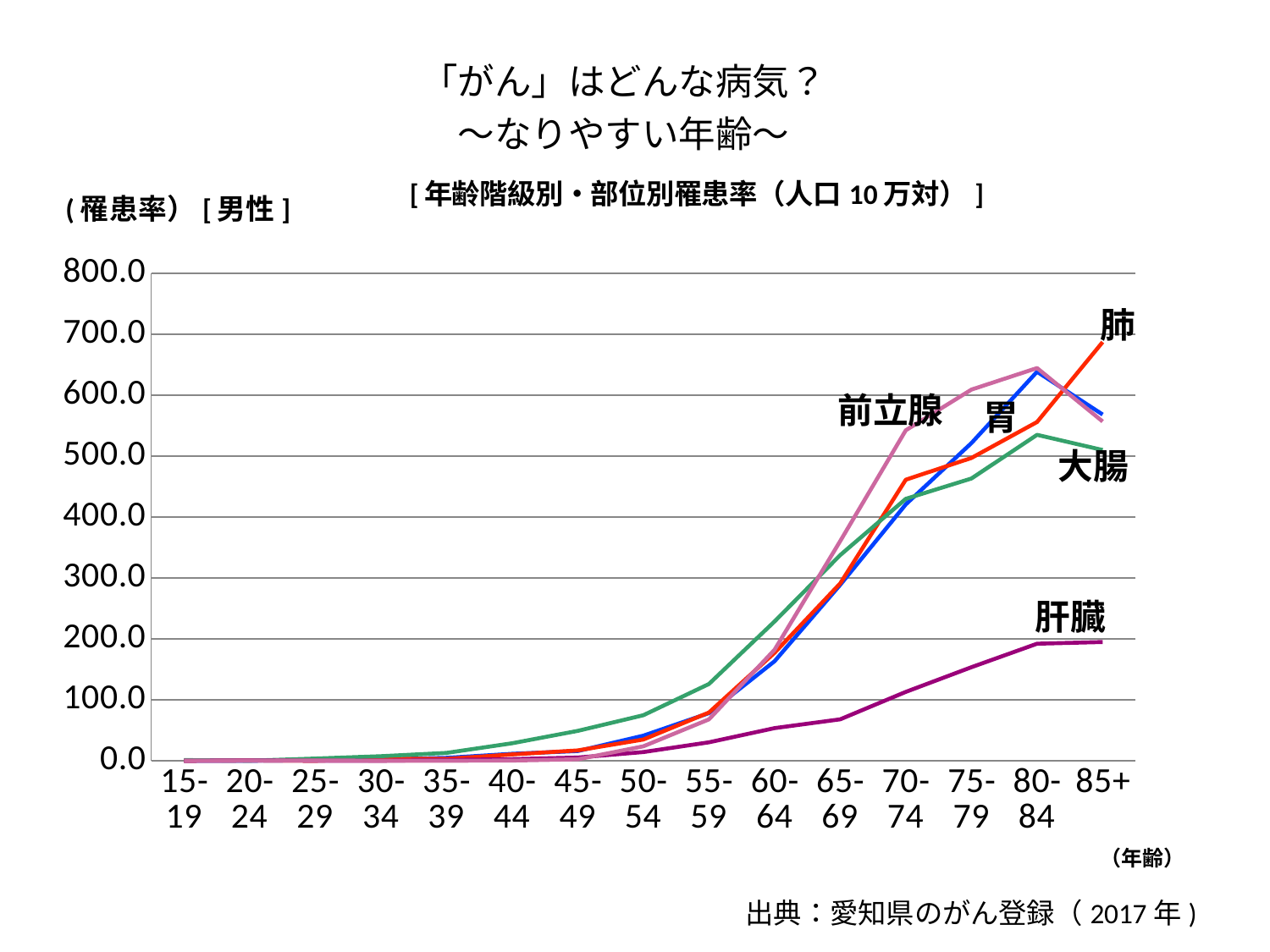
Does the incidence rate for 肝臓 rise or fall as age increases along the x axis? rises Which cancer site has the lowest incidence rate at age 85+? 肝臓 How many cancer sites (series) are plotted on the chart? 5 Which cancer site has the highest incidence rate in the 75-79 age group? 前立腺 Is the value for 肺 at age 85+ greater or less than 600? greater What is the highest tick value shown on the y axis? 800.0 Is the value for 大腸 at age 85+ greater or less than 400? greater In the 60-64 age group, which is larger, the value for 大腸 or the value for 肝臓? 大腸 What kind of chart is shown on the slide? line chart Which cancer site has the highest incidence rate at age 85+? 肺 Is the value for 肝臓 at age 85+ greater or less than 300? less How many age groups are shown on the x axis? 15